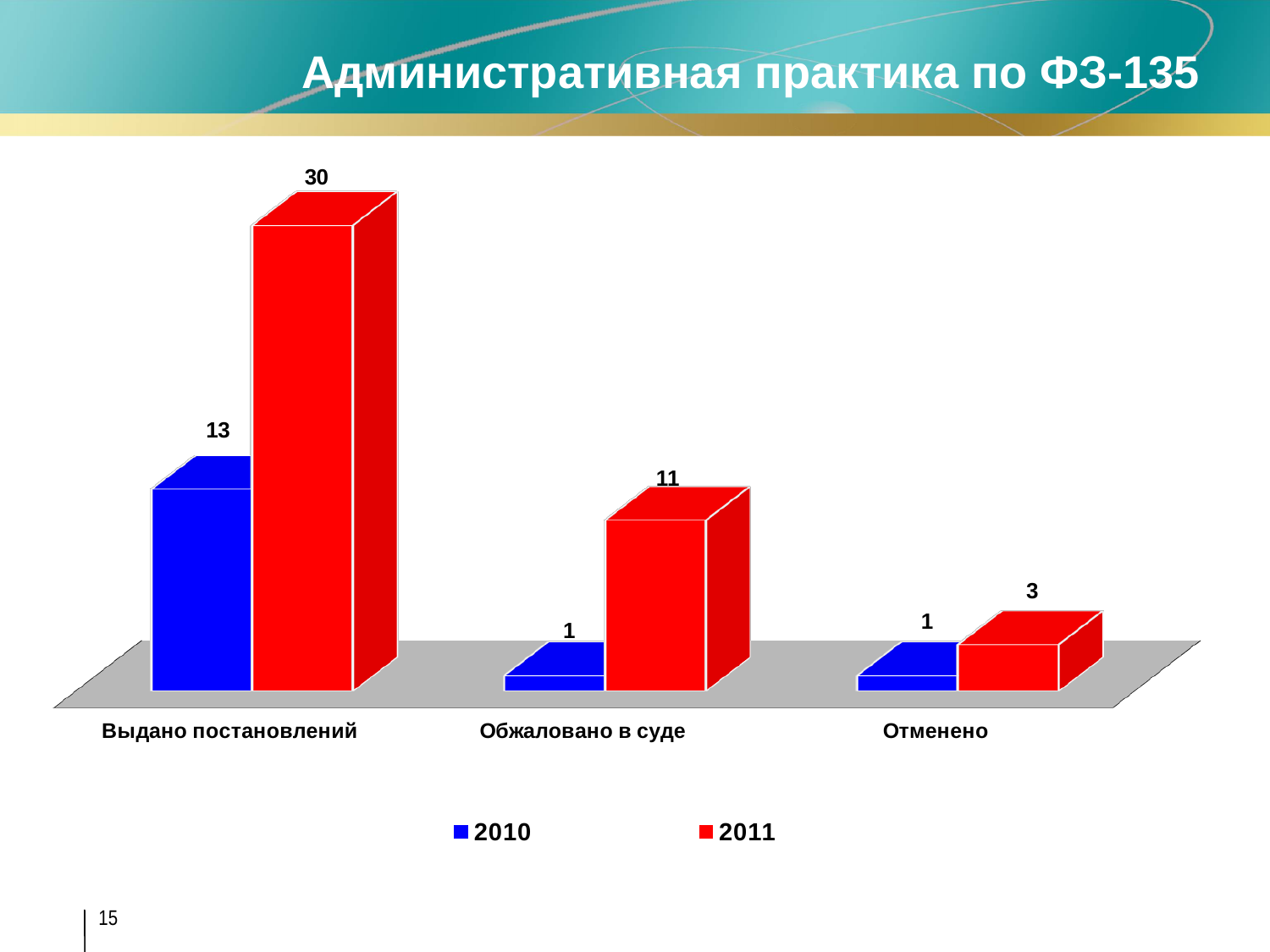
What is the difference between the 2011 and 2010 values for "Обжаловано в суде"? 10 How many categories are shown on the x axis? 3 How many series does the legend list? 2 What is the difference between the 2011 and 2010 values for "Выдано постановлений"? 17 What is the value for 2010 in the "Выдано постановлений" category? 13 What type of chart is shown on the slide? Bar chart Which is larger for "Отменено": the 2010 value or the 2011 value? 2011 What is the value for 2010 in the "Отменено" category? 1 Which category has the lowest value for 2011? Отменено Which category has the highest value for 2011? Выдано постановлений What is the value for 2011 in the "Обжаловано в суде" category? 11 What is the value for 2011 in the "Выдано постановлений" category? 30